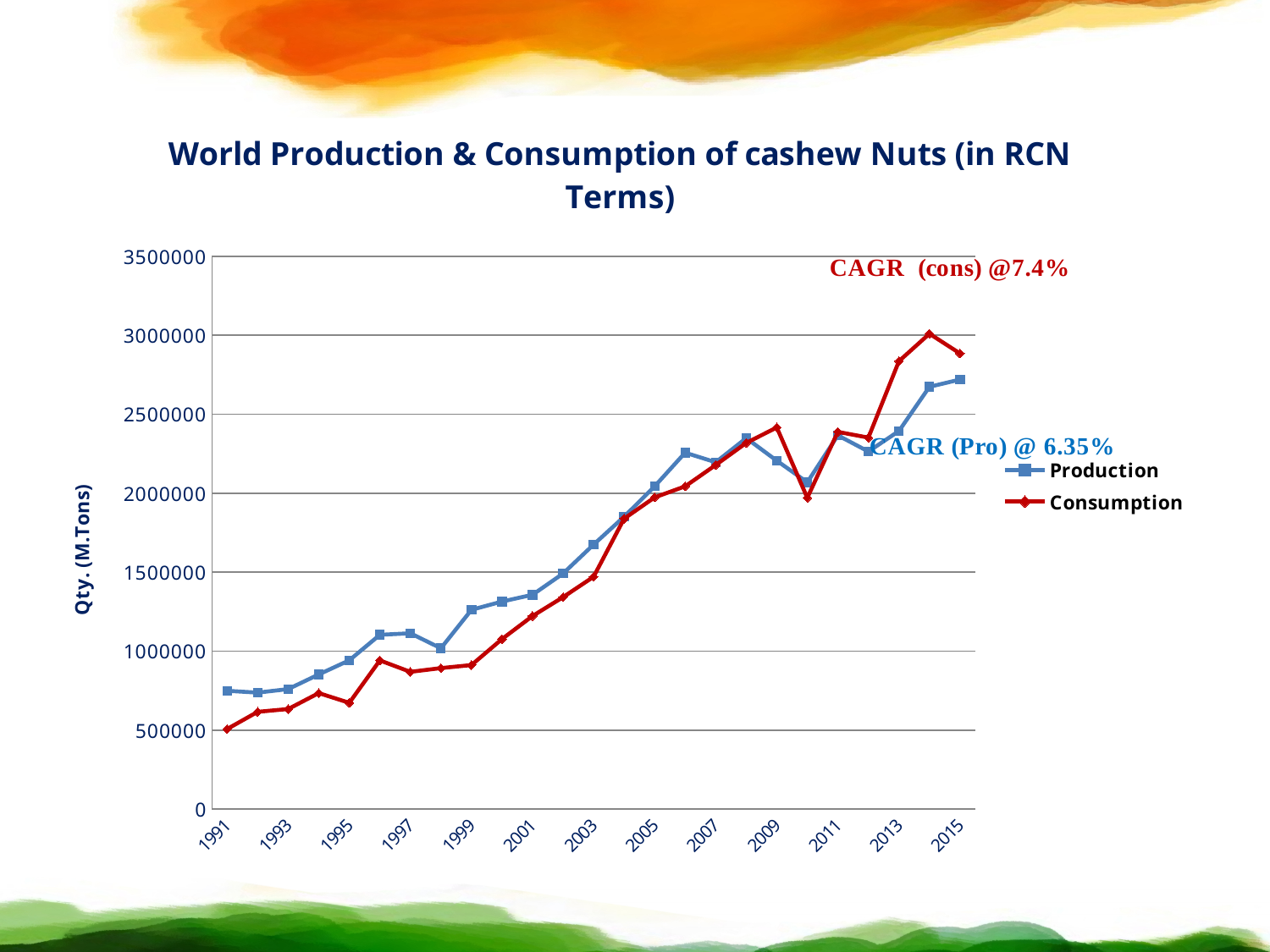
What CAGR is stated for production on the chart? 6.35% In 1991, which series has the higher value, Production or Consumption? Production What are the two series shown in the legend? Production and Consumption How many series does the legend list? 2 Is the Production value for 2015 greater or less than 2500000? greater Do the Production values generally rise or fall from 1991 to 2015? rise What CAGR is stated for consumption on the chart? 7.4% In 2015, which series has the higher value, Production or Consumption? Consumption Is the Production value for 1991 greater or less than 500000? greater Is the Consumption value for 1991 greater or less than 1000000? less What kind of chart is shown on the slide? line chart What is the title of the y axis? Qty. (M.Tons)